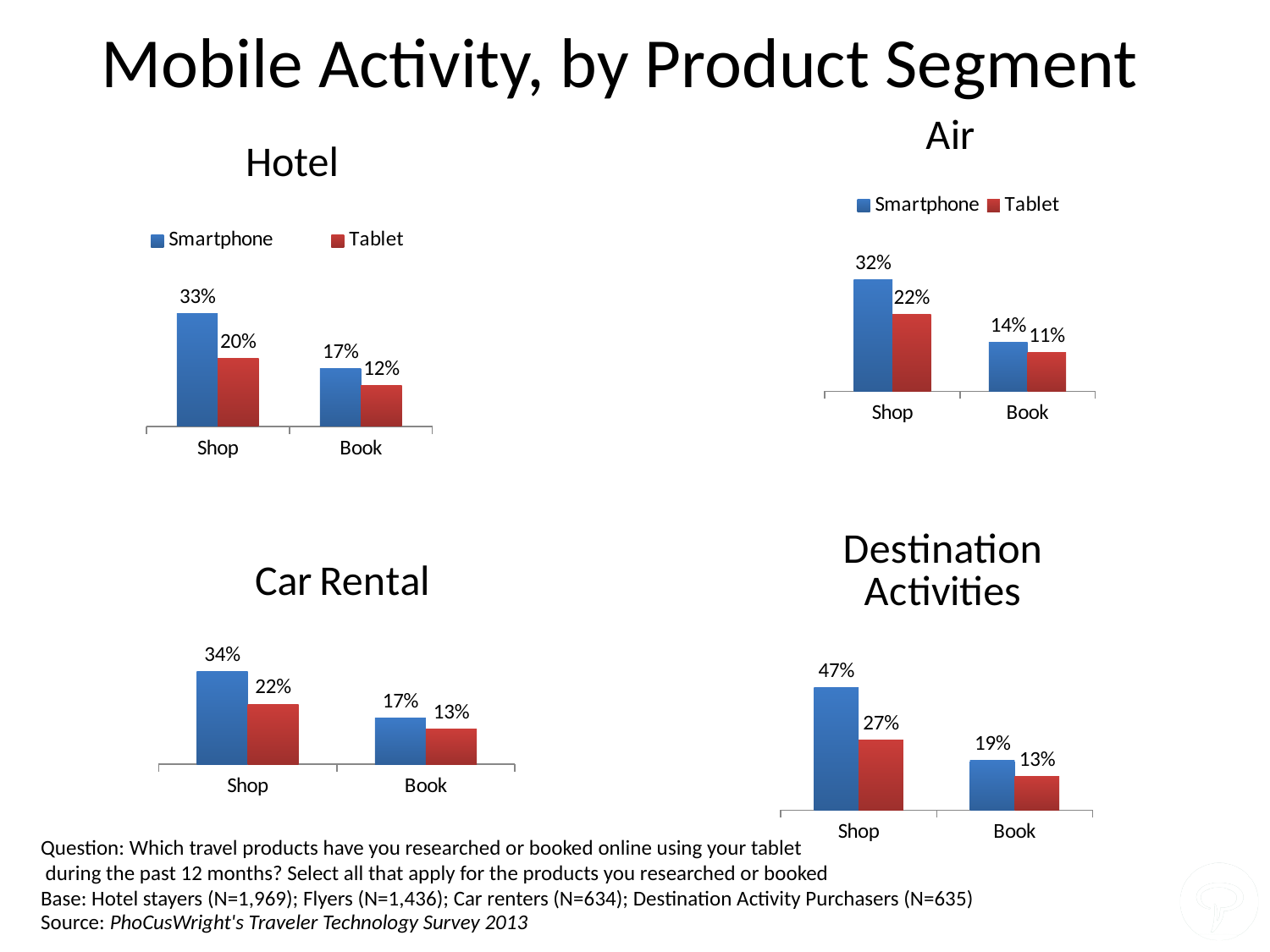
In the Hotel chart, which category has the highest Smartphone value? Shop What kind of chart is the Car Rental chart? Bar chart In the Hotel chart, what is the Smartphone value for Shop? 33% In the Air chart, what is the Tablet value for Shop? 22% In the Air chart, which series has the lowest value for Book? Tablet In the Destination Activities chart, what is the difference between the Smartphone and Tablet values for Shop? 20% How many series does the legend of the Hotel chart list? 2 In the Car Rental chart, which is larger: the Tablet value for Shop or the Smartphone value for Book? Tablet value for Shop In the Air chart, what is the difference between the Smartphone values for Shop and Book? 18% In the Hotel chart, what is the Tablet value for Book? 12% In the Car Rental chart, what is the Smartphone value for Book? 17% In the Destination Activities chart, what is the Smartphone value for Shop? 47%